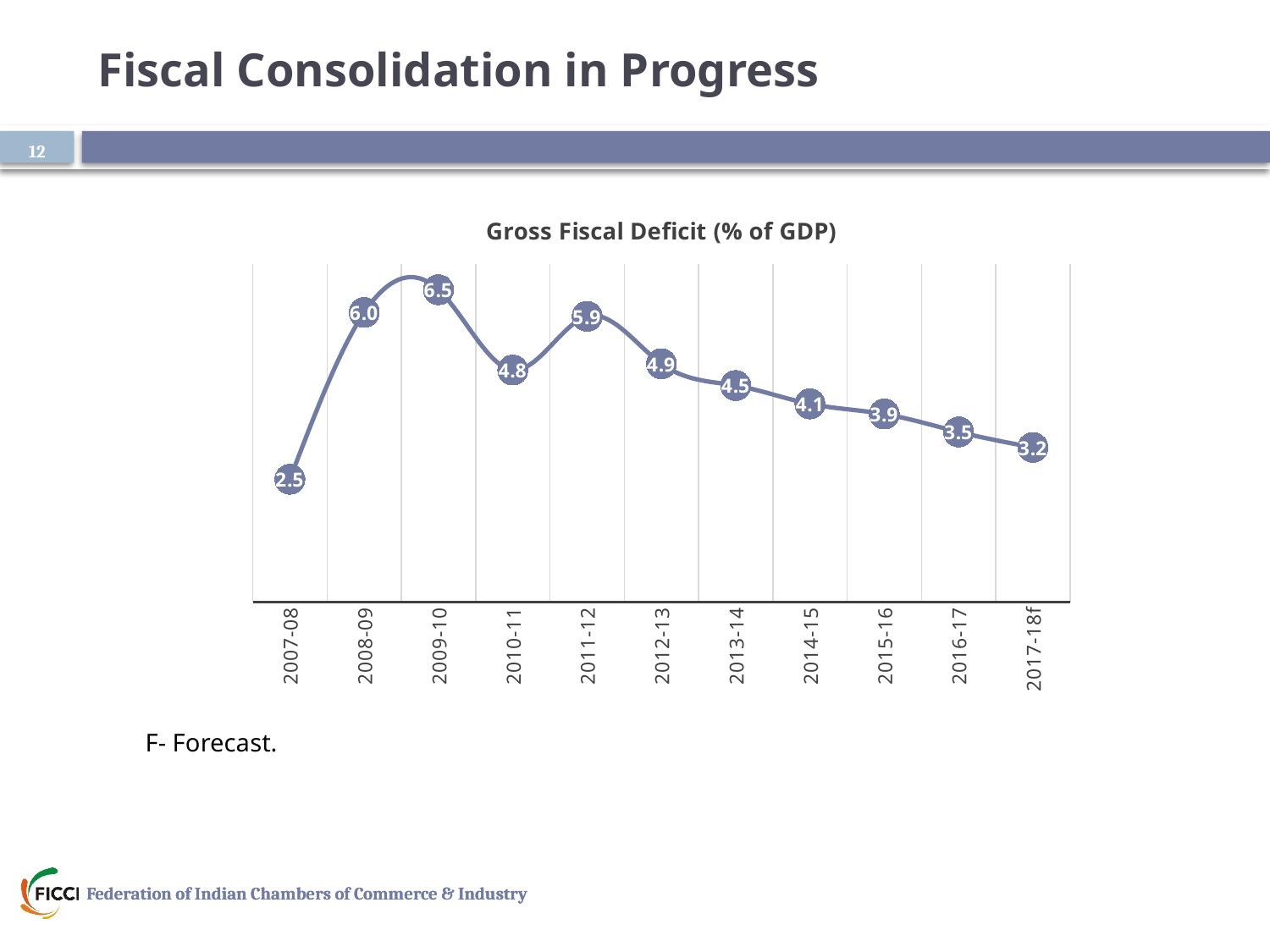
What is the Gross Fiscal Deficit (% of GDP) forecast for 2017-18f? 3.2 What is the Gross Fiscal Deficit (% of GDP) for 2007-08? 2.5 What kind of chart is used to show the Gross Fiscal Deficit (% of GDP)? Line chart What is the title of the chart on the slide? Gross Fiscal Deficit (% of GDP) Which is larger, the Gross Fiscal Deficit in 2011-12 or in 2012-13? 2011-12 What is the Gross Fiscal Deficit (% of GDP) for 2009-10? 6.5 Which year has the highest Gross Fiscal Deficit (% of GDP)? 2009-10 What is the difference between the Gross Fiscal Deficit in 2009-10 and 2010-11? 1.7 What is the Gross Fiscal Deficit (% of GDP) for 2013-14? 4.5 How many years are plotted on the Gross Fiscal Deficit chart? 11 From 2011-12 to 2017-18f, does the Gross Fiscal Deficit rise or fall? Fall Which year has the lowest Gross Fiscal Deficit (% of GDP)? 2007-08